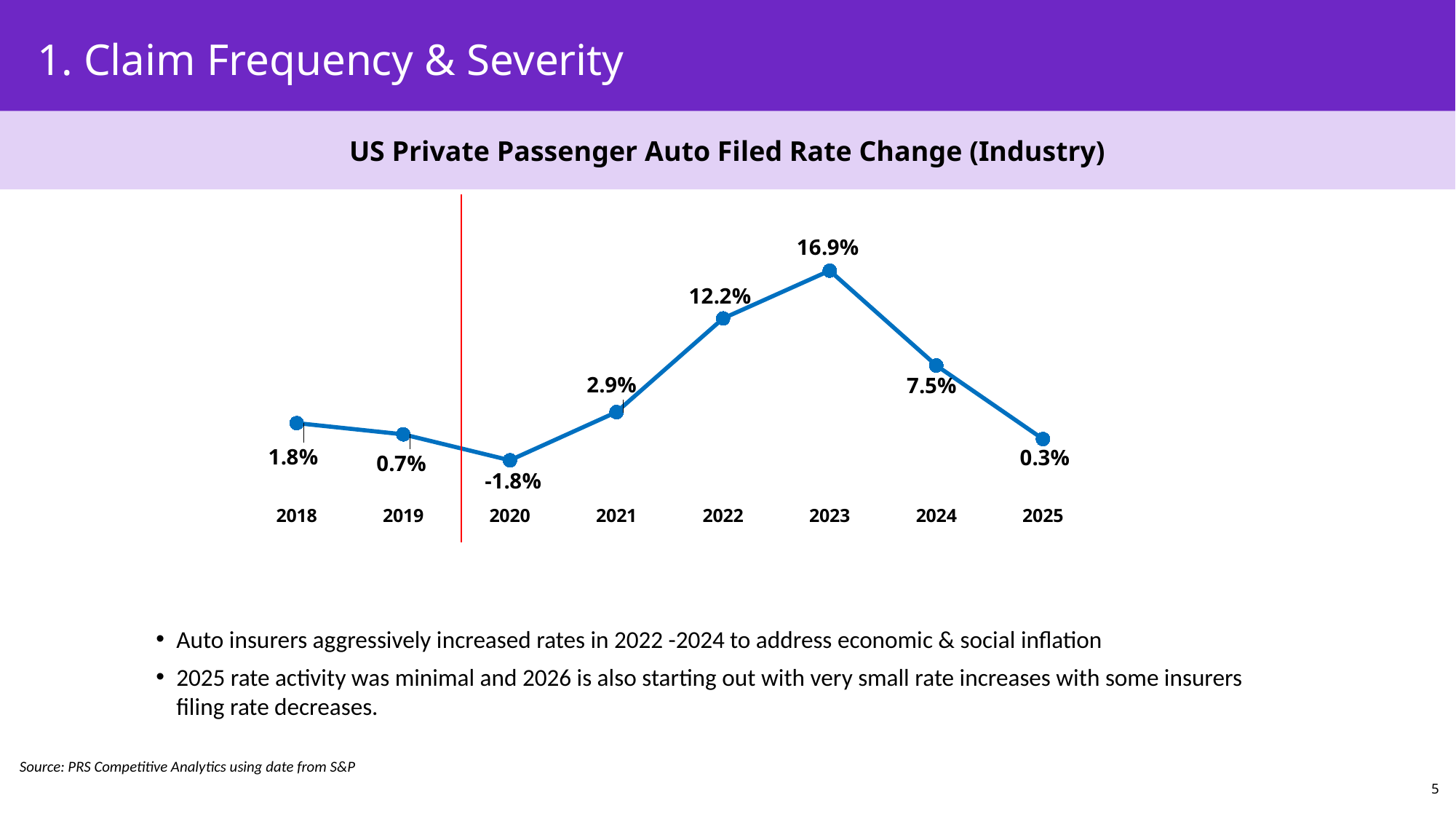
What is the filed rate change for 2019? 0.7% What is the filed rate change for 2025? 0.3% Which year has a larger filed rate change, 2021 or 2024? 2024 What is the difference between the filed rate change in 2023 and in 2022? 4.7% How many years are plotted on the chart? 8 What is the filed rate change for 2020? -1.8% Which year has the lowest filed rate change? 2020 What kind of chart is shown on the slide? Line chart Do the values rise or fall from 2023 to 2025? Fall Which year has the highest filed rate change? 2023 What is the filed rate change for 2023? 16.9% What is the difference between the filed rate change in 2024 and in 2025? 7.2%